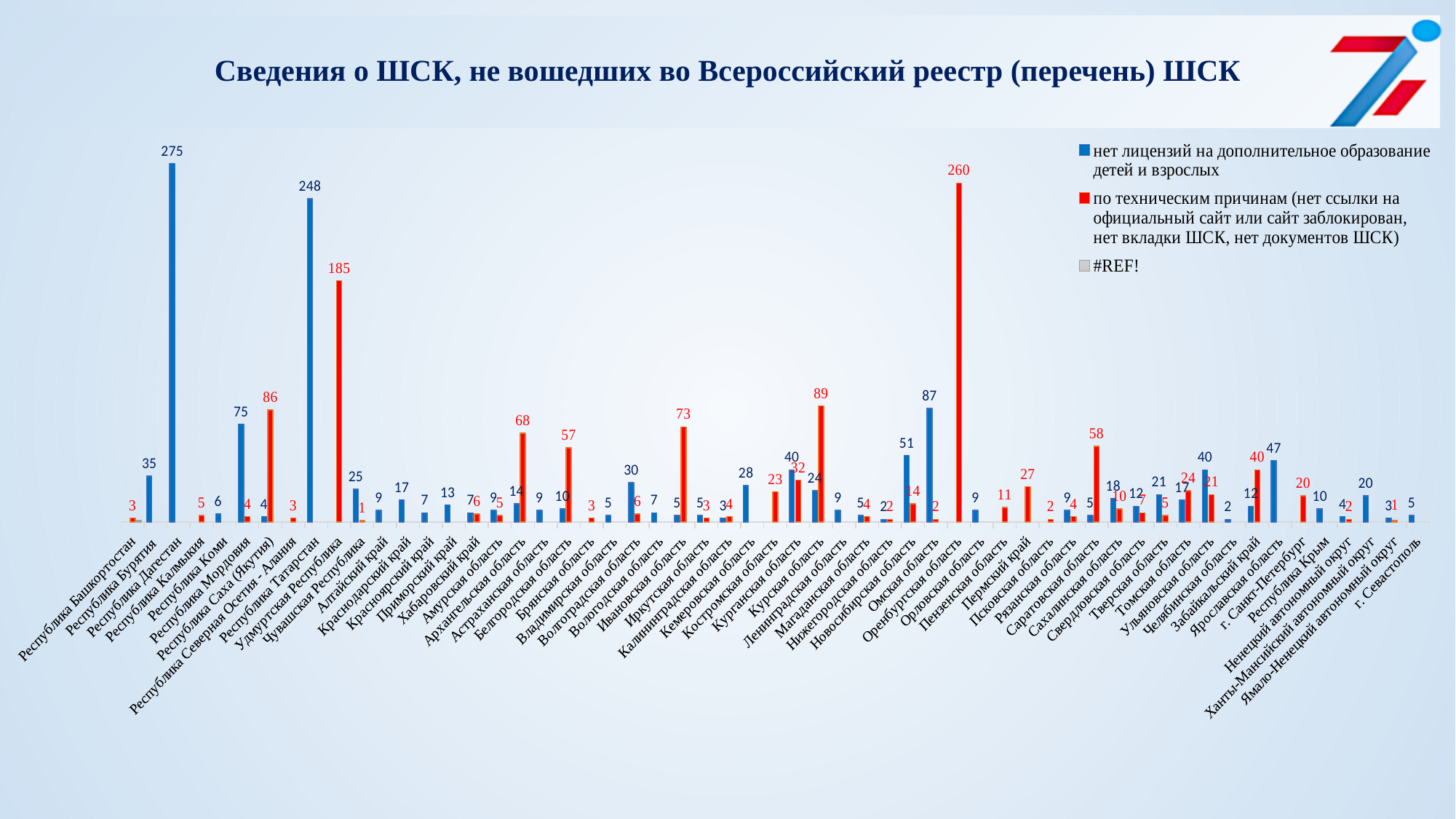
What is the value for Республика Дагестан in the series 'нет лицензий на дополнительное образование детей и взрослых'? 275 How many series does the legend list? 3 Which is larger: the blue value for Республика Дагестан or the red value for Оренбургская область? Республика Дагестан What is the value for Удмуртская Республика in the series 'по техническим причинам'? 185 Which region has the highest value for the series 'нет лицензий на дополнительное образование детей и взрослых'? Республика Дагестан What is the value for Республика Татарстан in the series 'нет лицензий на дополнительное образование детей и взрослых'? 248 What is the difference between the values for Республика Дагестан (275) and Республика Татарстан (248) in the blue series? 27 What kind of chart is shown on the slide? bar chart What is the title of the chart? Сведения о ШСК, не вошедших во Всероссийский реестр (перечень) ШСК What is the value for Оренбургская область in the series 'по техническим причинам'? 260 What is the difference between the red values for Оренбургская область (260) and Удмуртская Республика (185)? 75 Which region has the highest value for the series 'по техническим причинам'? Оренбургская область